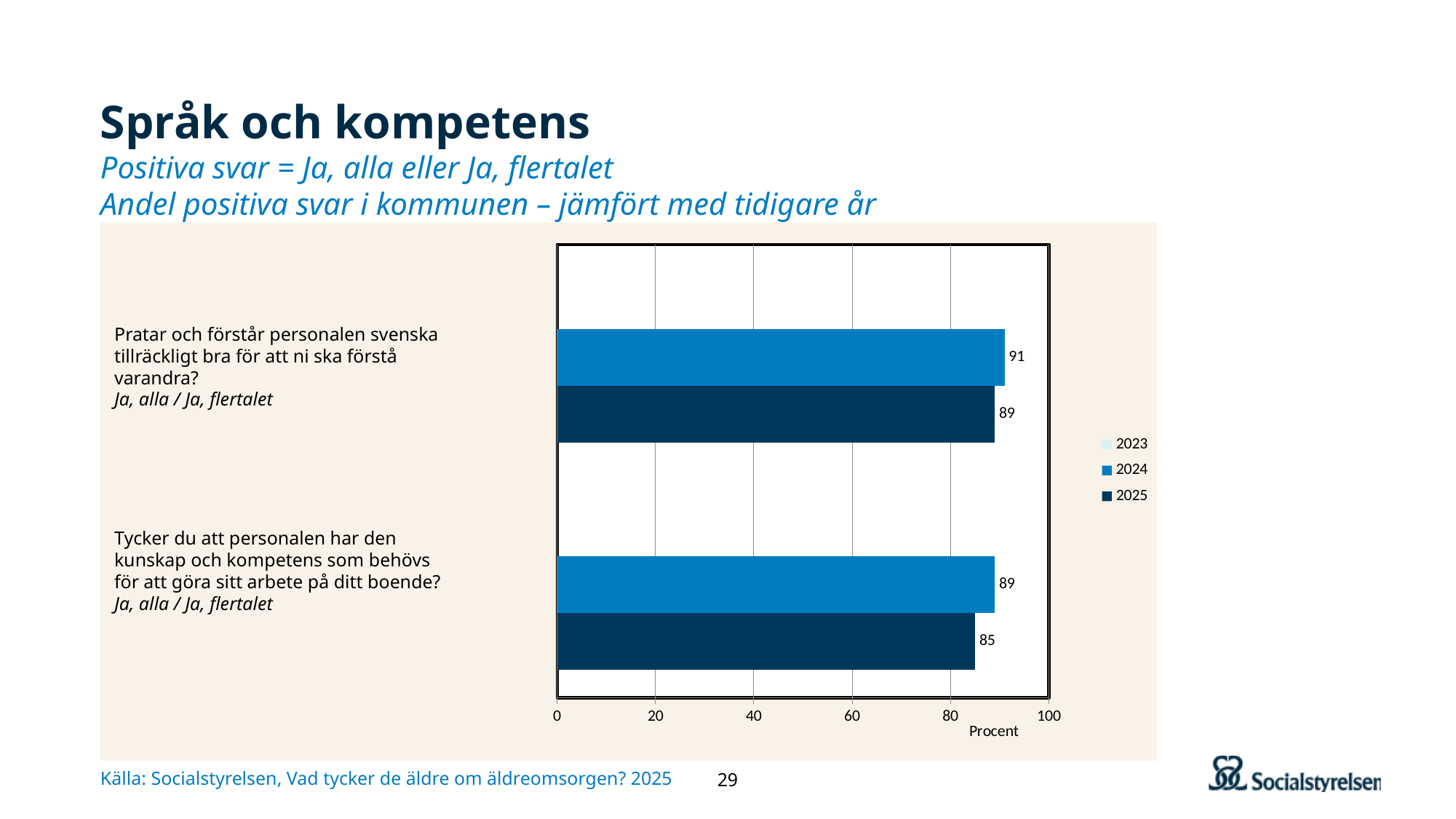
What is the 2025 value for "Tycker du att personalen har den kunskap och kompetens som behövs för att göra sitt arbete på ditt boende?"? 85 What kind of chart is shown on the slide? Bar chart How many question categories are shown in the chart? 2 What is the 2024 value for "Pratar och förstår personalen svenska tillräckligt bra för att ni ska förstå varandra?"? 91 What is the difference between the 2024 and 2025 values for "Pratar och förstår personalen svenska tillräckligt bra för att ni ska förstå varandra?"? 2 Which bar in the chart has the lowest value? 2025 for "Tycker du att personalen har den kunskap och kompetens som behövs för att göra sitt arbete på ditt boende?" What is the 2024 value for "Tycker du att personalen har den kunskap och kompetens som behövs för att göra sitt arbete på ditt boende?"? 89 For "Tycker du att personalen har den kunskap och kompetens som behövs för att göra sitt arbete på ditt boende?", is the 2024 value or the 2025 value larger? 2024 What is the difference between the 2024 and 2025 values for "Tycker du att personalen har den kunskap och kompetens som behövs för att göra sitt arbete på ditt boende?"? 4 Which bar in the chart has the highest value? 2024 for "Pratar och förstår personalen svenska tillräckligt bra för att ni ska förstå varandra?" How many series does the legend list? 3 What is the 2025 value for "Pratar och förstår personalen svenska tillräckligt bra för att ni ska förstå varandra?"? 89